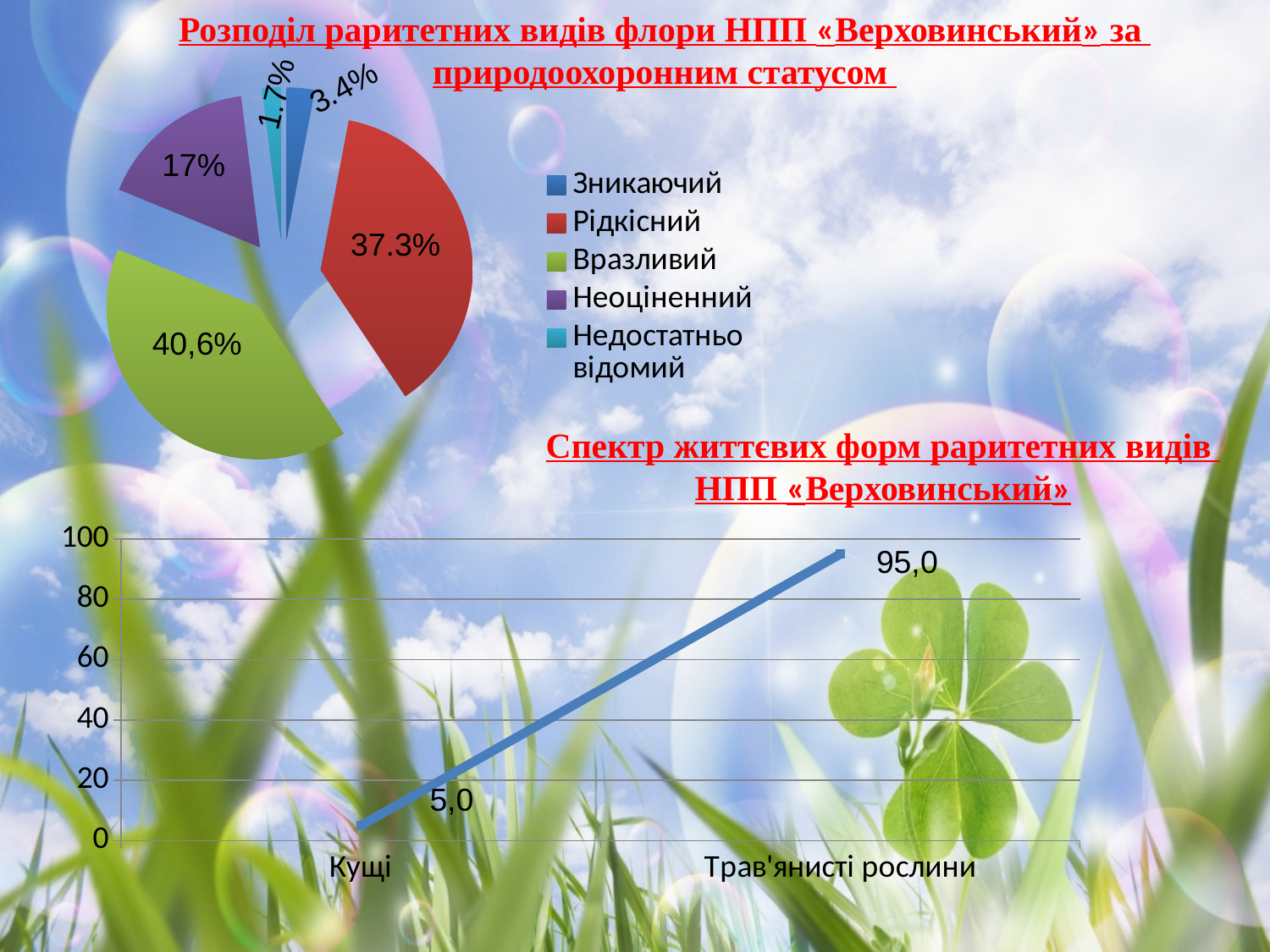
In the chart titled 'Спектр життєвих форм раритетних видів НПП «Верховинський»', what kind of chart is shown? Line chart In the pie chart on the distribution of rare flora species by conservation status, which is larger: Рідкісний or Неоціненний? Рідкісний In the pie chart on the distribution of rare flora species by conservation status, how many categories does the legend list? 5 In the pie chart on the distribution of rare flora species by conservation status, which category has the largest slice? Вразливий In the pie chart on the distribution of rare flora species by conservation status, which category has the smallest slice? Недостатньо відомий In the chart titled 'Спектр життєвих форм раритетних видів НПП «Верховинський»', what is the value for Трав'янисті рослини? 95,0 In the pie chart on the distribution of rare flora species by conservation status, what share is labelled for Зникаючий? 3.4% In the pie chart on the distribution of rare flora species by conservation status, what share is labelled for Неоціненний? 17% In the pie chart on the distribution of rare flora species by conservation status, what share is labelled for Вразливий? 40,6% In the pie chart on the distribution of rare flora species by conservation status, what share is labelled for Рідкісний? 37.3% In the chart titled 'Спектр життєвих форм раритетних видів НПП «Верховинський»', what is the value for Кущі? 5,0 In the pie chart on the distribution of rare flora species by conservation status, what colour is the Рідкісний slice? Red